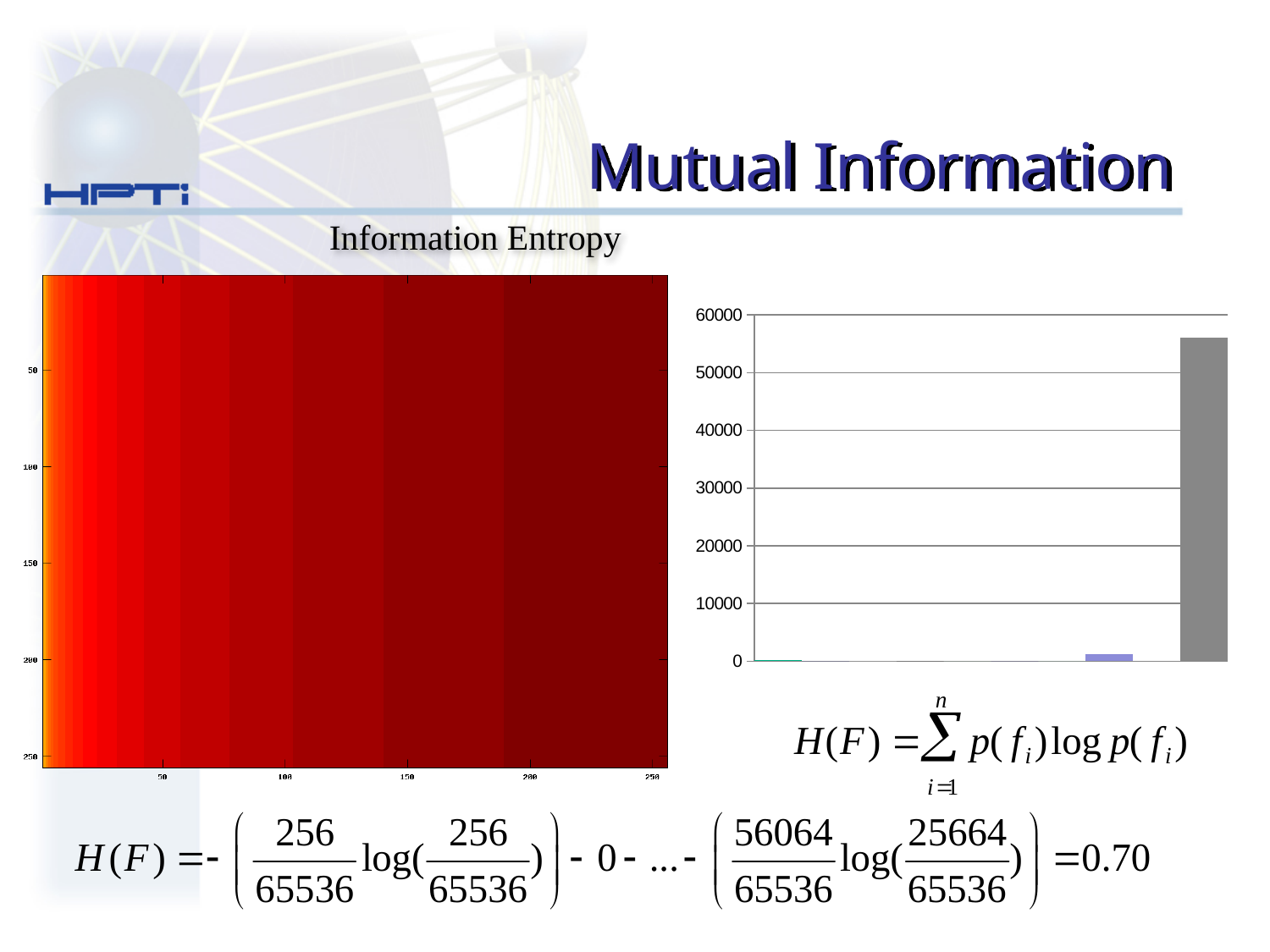
In the bar chart, is the value of the small purple bar greater or less than 10000? less What kind of chart is shown on the right side of the slide? bar chart In the bar chart, is the value of the tall gray bar on the right greater or less than 60000? less What is the interval between consecutive tick labels on the y-axis of the bar chart? 10000 In the bar chart, is the value of the tall gray bar on the right greater or less than 50000? greater In the bar chart, which is larger: the purple bar or the gray bar? the gray bar How many visible bars are there in the bar chart? 3 What is the highest value shown on the y-axis of the bar chart? 60000 In the bar chart, which bar is the tallest: the leftmost, the middle, or the rightmost? the rightmost